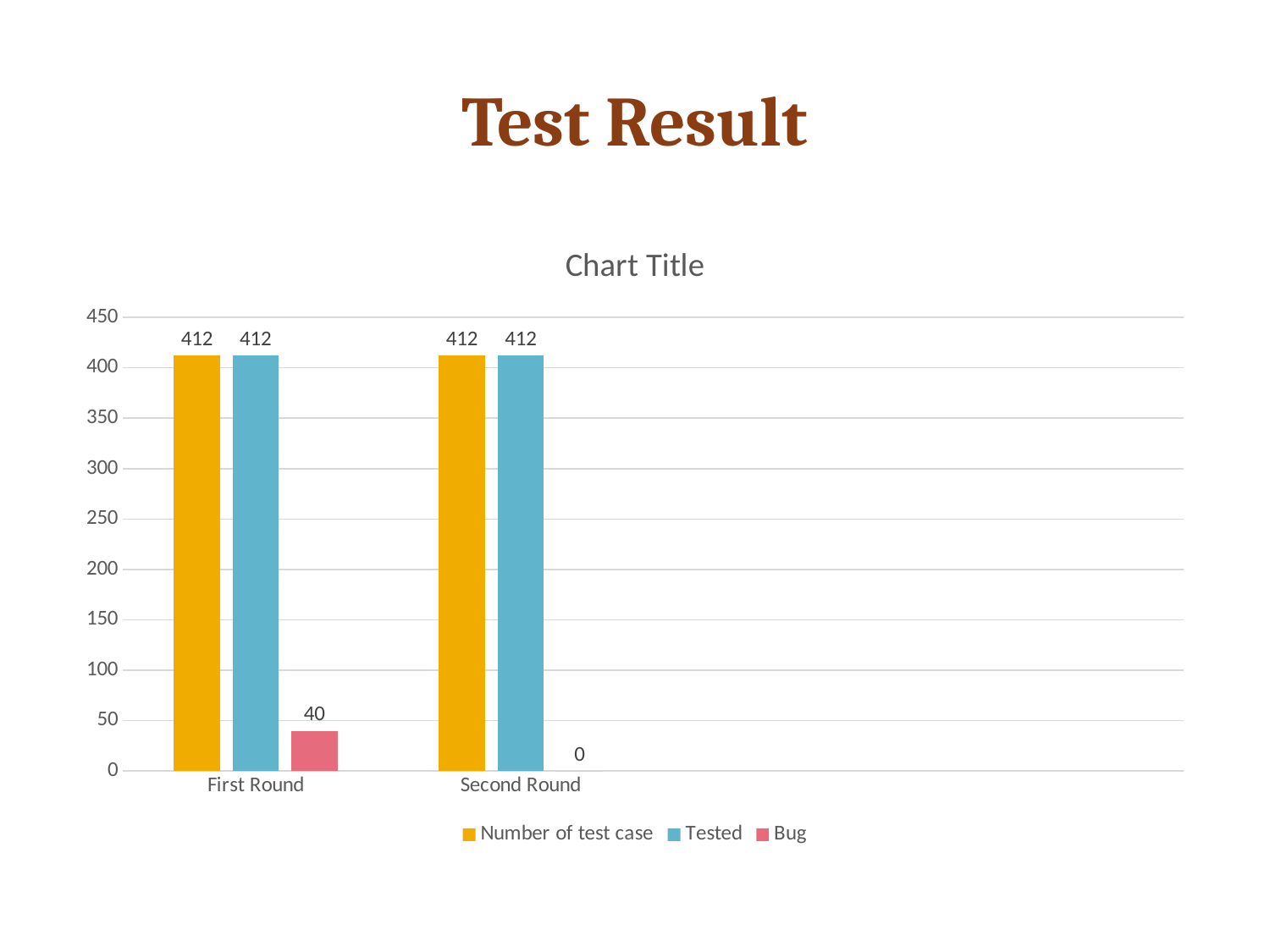
In which round is the Bug value highest? First Round What is the value of Bug in the Second Round? 0 Which is larger in the First Round, Tested or Bug? Tested What is the value of Number of test case in the First Round? 412 What is the difference between the Bug values in the First Round and the Second Round? 40 What kind of chart is shown on the slide? Bar chart How many series does the legend list? 3 What is the value of Bug in the First Round? 40 What is the value of Tested in the Second Round? 412 What is the difference between Number of test case and Bug in the First Round? 372 In which round is the Bug value lowest? Second Round How many categories are shown on the x axis? 2